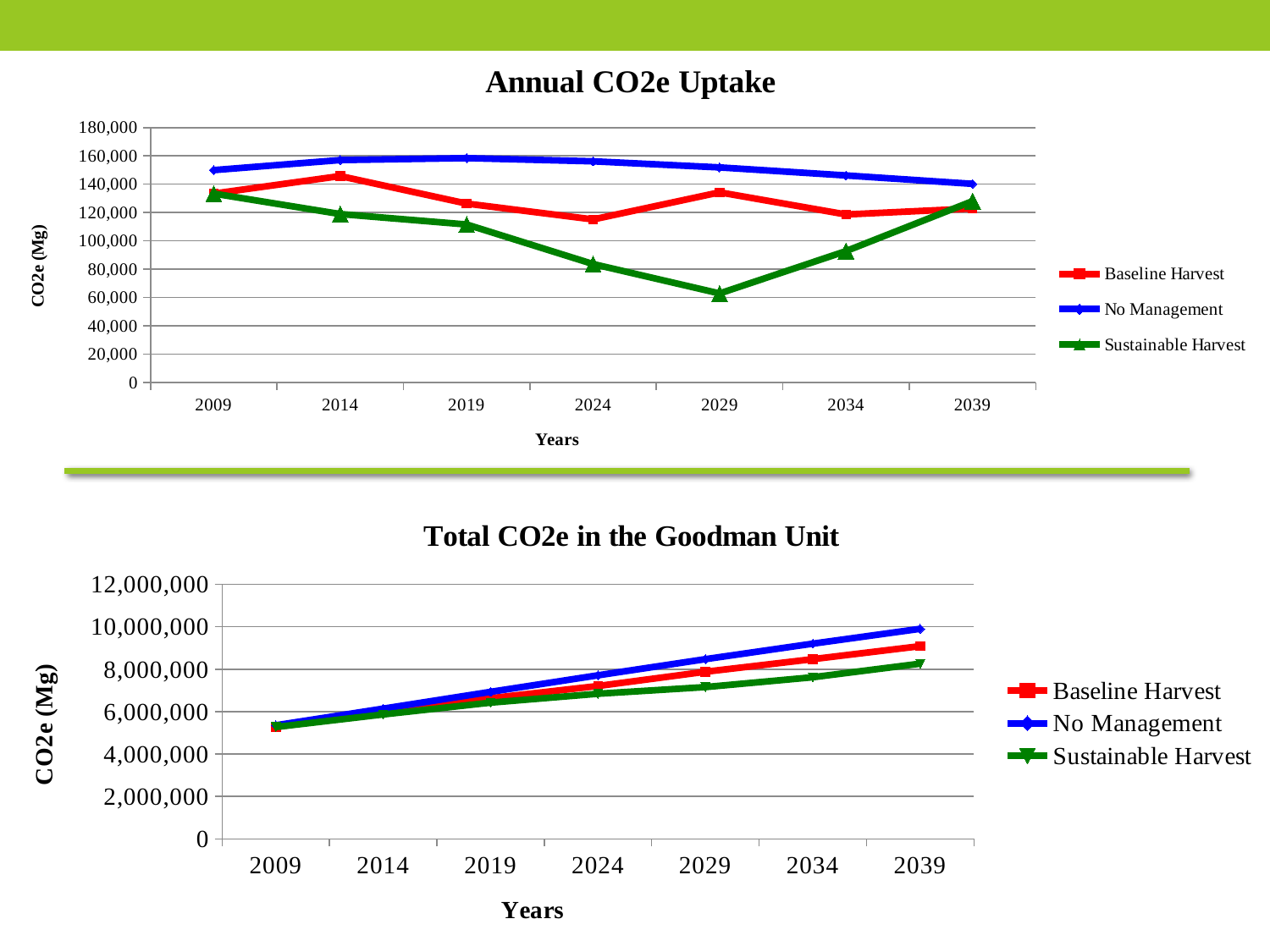
In the 'Annual CO2e Uptake' chart, which series has the lowest value in 2029? Sustainable Harvest In the 'Annual CO2e Uptake' chart, is the Sustainable Harvest value for 2029 greater or less than 80,000? less How many series does the legend of the 'Annual CO2e Uptake' chart list? 3 In the 'Annual CO2e Uptake' chart, which series has the highest value in 2029? No Management In the 'Annual CO2e Uptake' chart, is the No Management value for 2019 greater or less than 140,000? greater What kind of chart is the 'Annual CO2e Uptake' chart? line chart In the 'Annual CO2e Uptake' chart, in which year does Sustainable Harvest reach its lowest value? 2029 In the 'Annual CO2e Uptake' chart, which is larger in 2024: Baseline Harvest or Sustainable Harvest? Baseline Harvest What is the y-axis title of the 'Total CO2e in the Goodman Unit' chart? CO2e (Mg) How many years are shown on the x axis of the 'Total CO2e in the Goodman Unit' chart? 7 In the 'Total CO2e in the Goodman Unit' chart, is the No Management value for 2039 greater or less than 8,000,000? greater In the 'Total CO2e in the Goodman Unit' chart, does the No Management series rise or fall from 2009 to 2039? rise